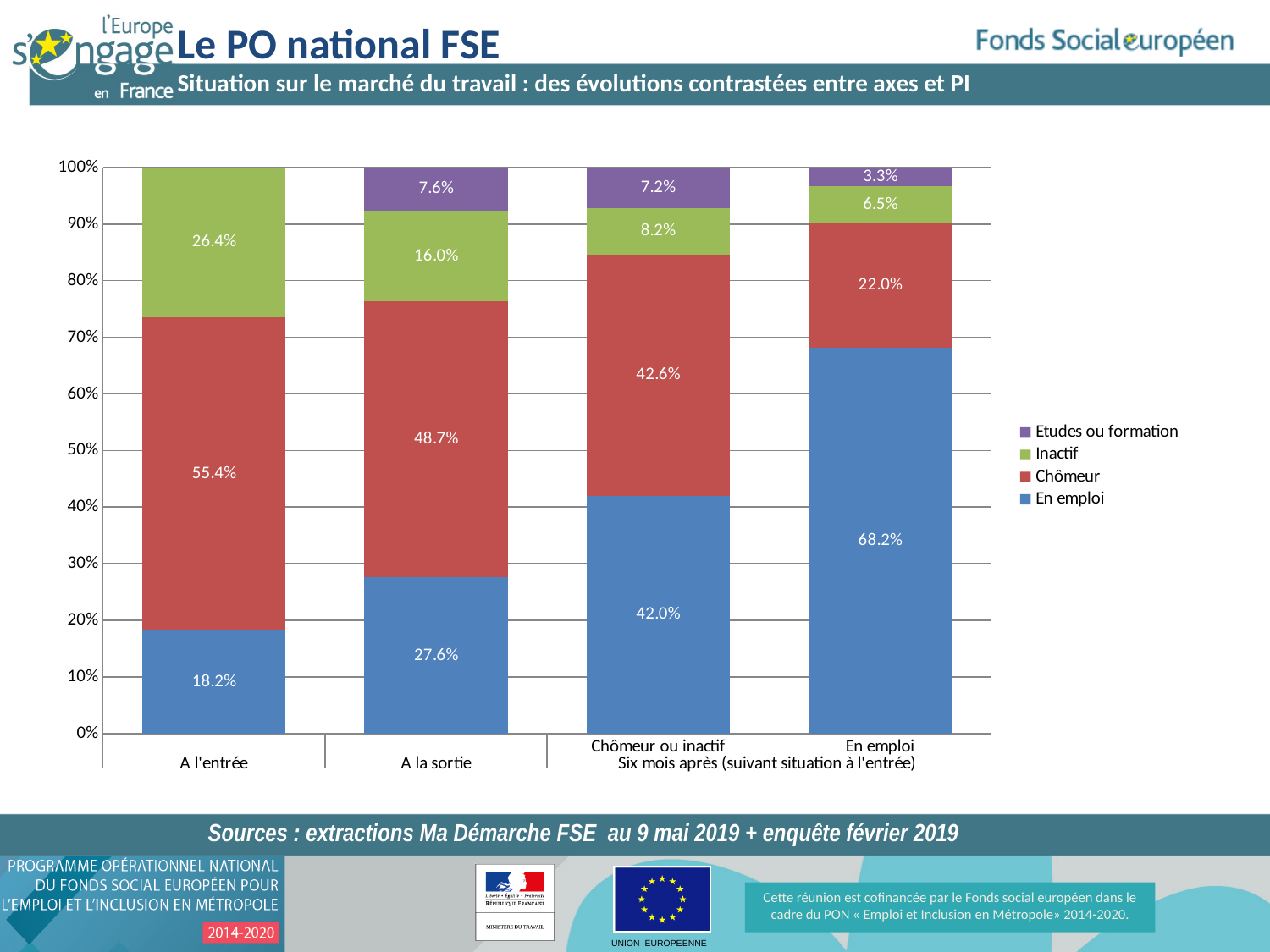
What is the value of 'Inactif' for the 'Chômeur ou inactif' category under 'Six mois après'? 8.2% What is the difference between the 'En emploi' values for 'A la sortie' and 'A l'entrée'? 9.4% Which category has the highest value for the 'En emploi' series? En emploi (Six mois après) What is the value of 'En emploi' for the category 'A l'entrée'? 18.2% Which is larger: the 'Inactif' value for 'A l'entrée' or for 'A la sortie'? A l'entrée Which category has the lowest value for the 'Chômeur' series? En emploi (Six mois après) What is the value of 'Chômeur' for the category 'A la sortie'? 48.7% How many series does the legend list? 4 What is the value of 'Etudes ou formation' for the 'En emploi' category under 'Six mois après'? 3.3% What kind of chart is shown on the slide? Stacked bar chart Does the 'En emploi' share rise or fall from 'A l'entrée' to 'A la sortie'? Rise Which colour represents the 'Chômeur' series in the legend? Red